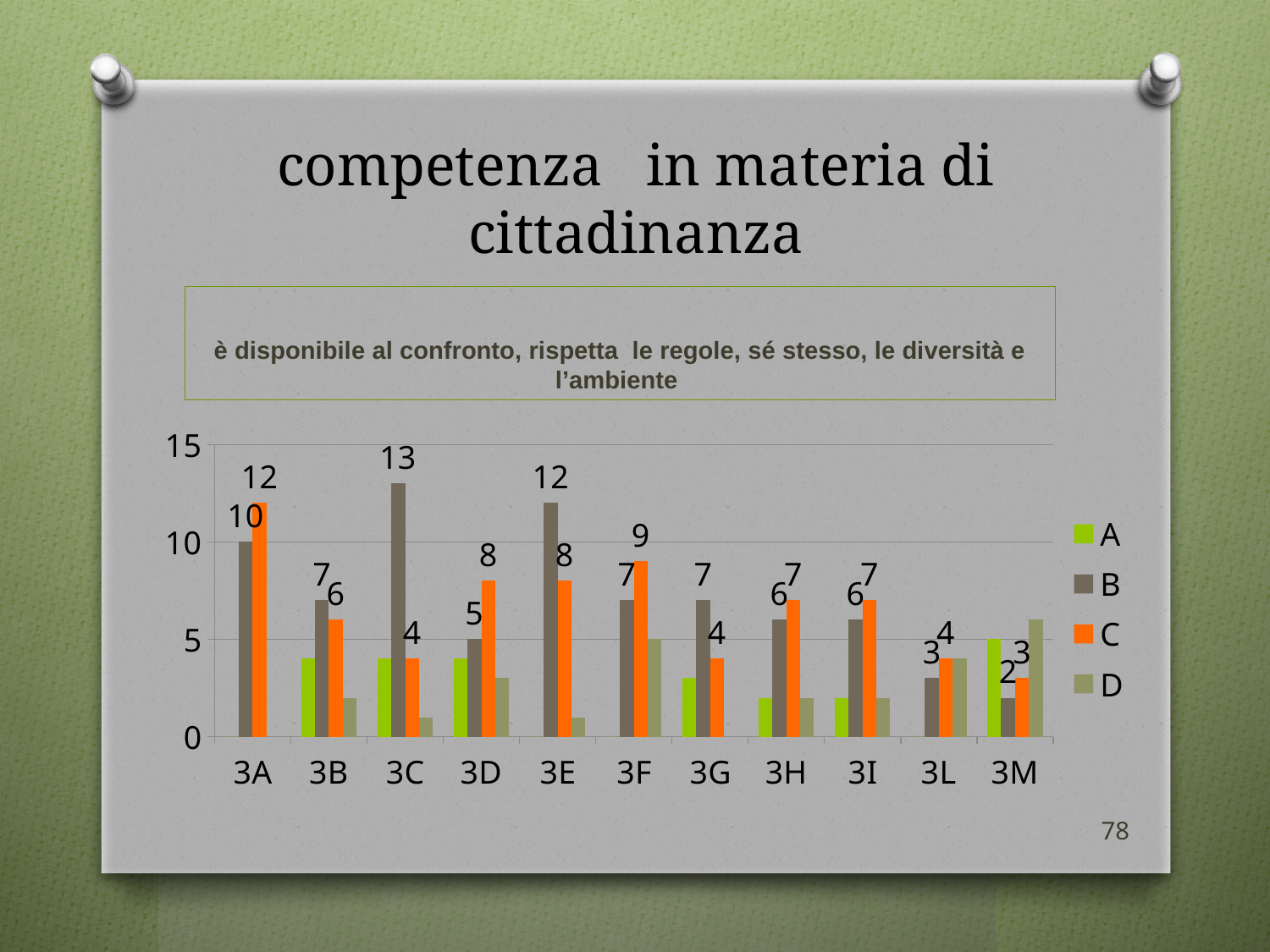
Which class has the highest value for series B? 3C What is the difference between series C and series B for class 3A? 2 What is the value of series B for class 3C? 13 How many series does the legend list? 4 Which class has the lowest value for series B? 3M What is the value of series C for class 3A? 12 For class 3F, which is larger: series B or series C? C Is the value of series A for class 3B greater or less than 5? less Which class has the highest value for series C? 3A What kind of chart is shown on the slide? bar chart How many classes are shown along the x axis? 11 What is the value of series C for class 3D? 8